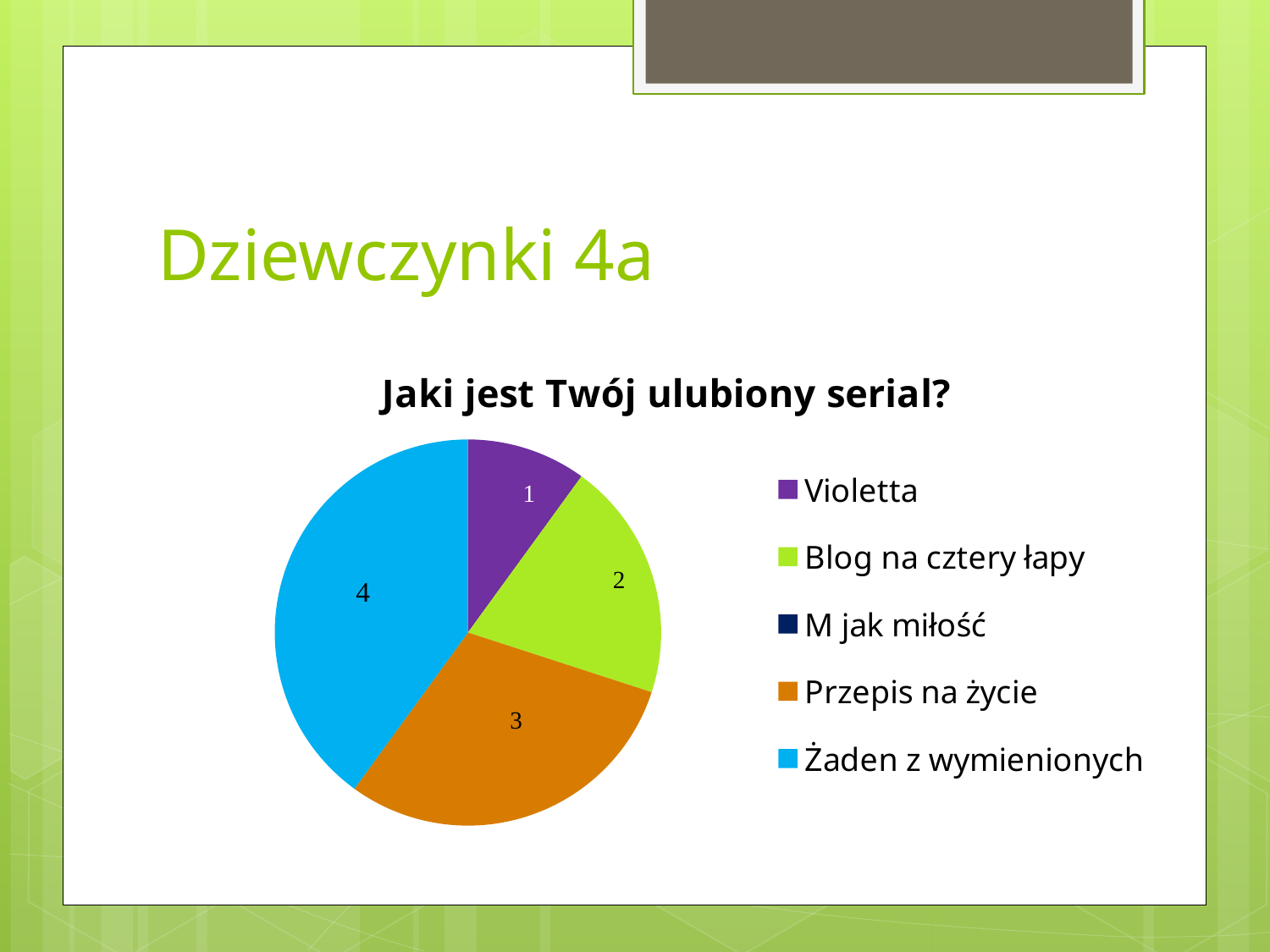
Which labelled slice has the smallest value? Violetta What is the difference between the values for Żaden z wymienionych and Violetta? 3 What is the value for Violetta? 1 What colour is the slice for Przepis na życie? orange How many entries does the legend list? 5 Which is larger, the value for Przepis na życie or the value for Blog na cztery łapy? Przepis na życie Which category has the largest slice? Żaden z wymienionych What is the value for Blog na cztery łapy? 2 What is the title of the chart? Jaki jest Twój ulubiony serial? What type of chart is shown on the slide? pie chart What is the value for Żaden z wymienionych? 4 What is the value for Przepis na życie? 3